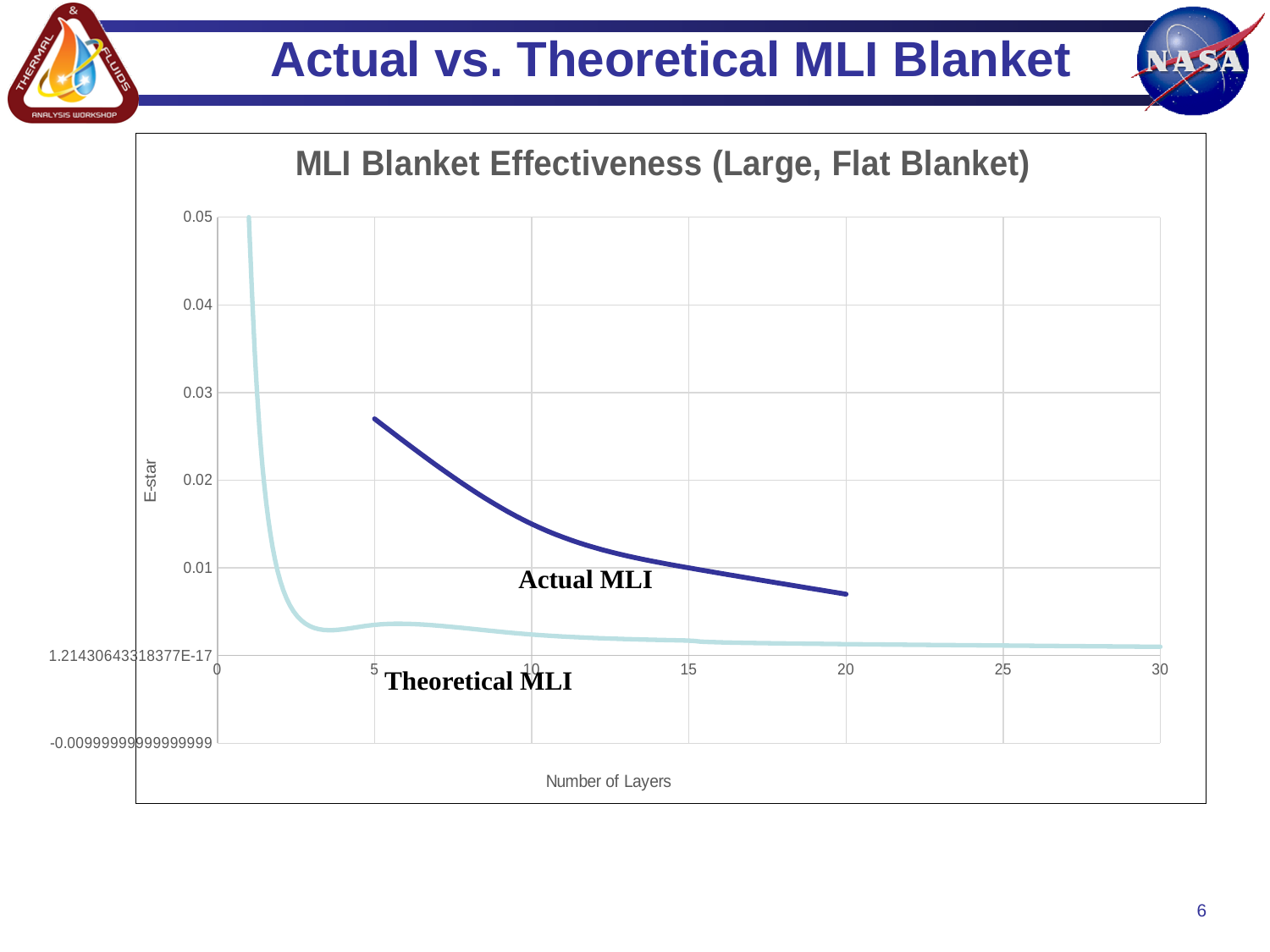
Does the Actual MLI line rise or fall as the number of layers increases? fall Is the Theoretical MLI value at 10 layers greater or less than 0.01? less Is the Actual MLI value at 5 layers greater or less than 0.02? greater Does the Theoretical MLI line rise or fall as the number of layers increases from 0 to 5? fall What is the title of the chart? MLI Blanket Effectiveness (Large, Flat Blanket) Is the Actual MLI value at 20 layers greater or less than 0.01? less At 10 layers, which line has the higher E-star value, Actual MLI or Theoretical MLI? Actual MLI What kind of chart is shown on the slide? line chart What is the label of the x axis? Number of Layers How many lines (series) are plotted on the chart? 2 Which line reaches the highest E-star value on the chart, Actual MLI or Theoretical MLI? Theoretical MLI